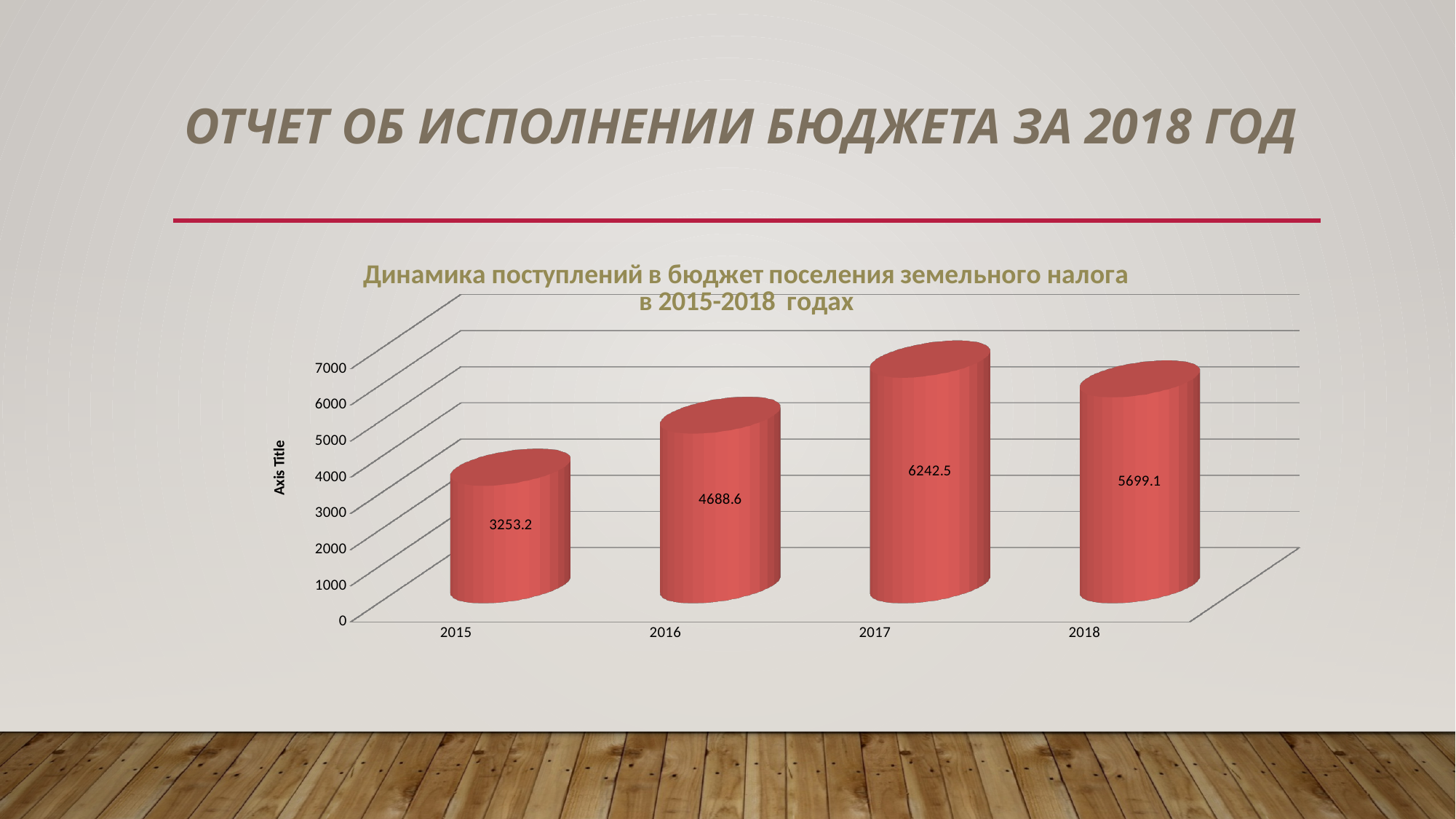
Which year has the lowest value? 2015 What is the value for 2017? 6242.5 What is the value for 2015? 3253.2 Do the values rise or fall from 2017 to 2018? Fall What is the difference between the values for 2018 and 2015? 2445.9 How many years are shown on the x axis? 4 What kind of chart is shown on the slide? Bar chart What is the difference between the values for 2017 and 2016? 1553.9 What is the value for 2016? 4688.6 What is the value for 2018? 5699.1 Which year has the highest value? 2017 Which is larger, the value for 2018 or the value for 2016? 2018